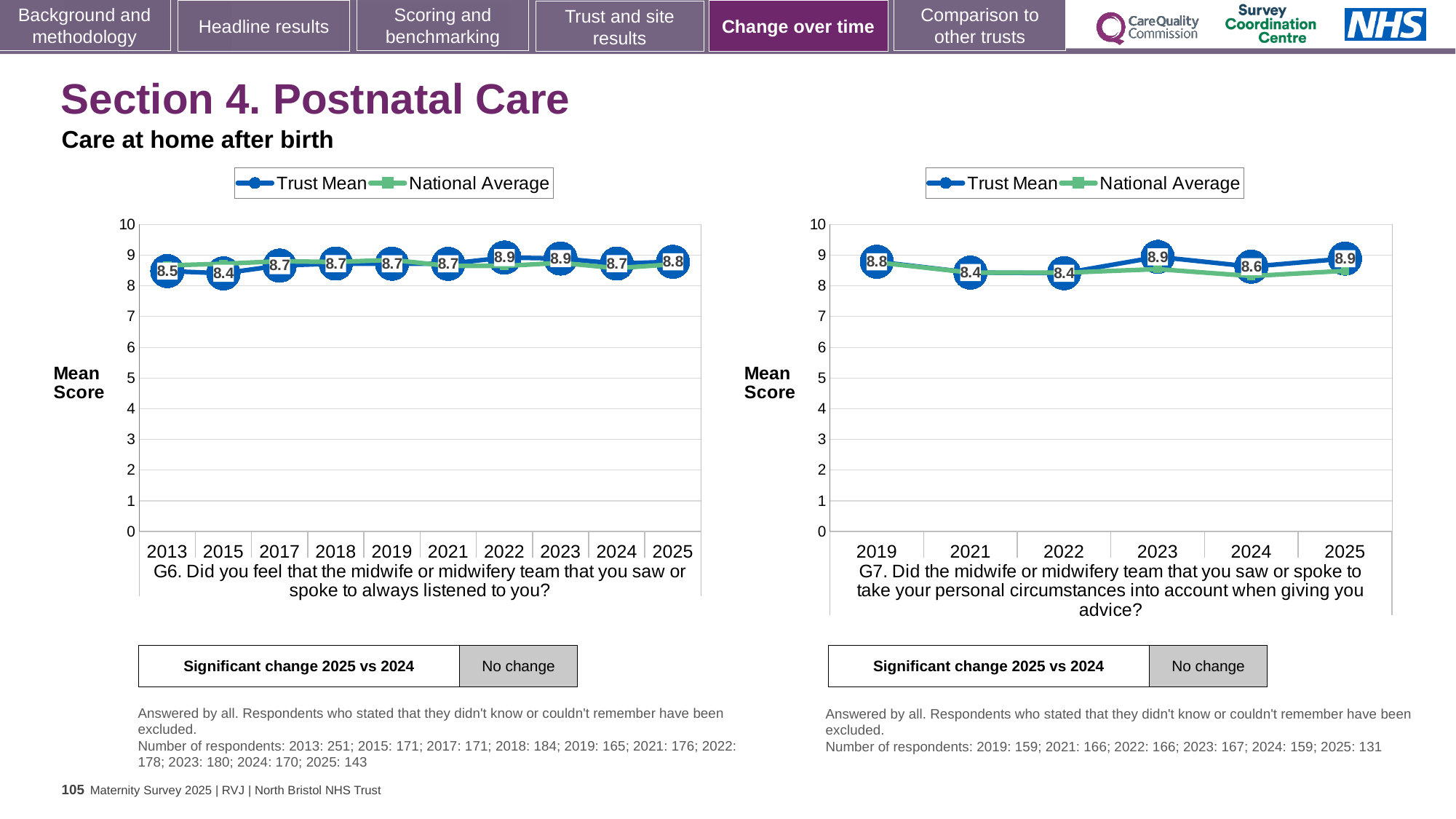
In the left chart (G6), which year has the lowest Trust Mean score? 2015 In the left chart (G6), how many years are plotted on the x axis? 10 In the left chart (G6), what is the difference between the Trust Mean scores for 2025 and 2013? 0.3 In the left chart (G6), is the Trust Mean score for 2022 larger or smaller than the score for 2015? larger In the left chart (G6), what is the Trust Mean score for 2025? 8.8 In the right chart (G7), what is the Trust Mean score for 2021? 8.4 How many series does the legend of the left chart (G6) list? 2 In the right chart (G7), is the National Average value for 2025 greater or less than 8? greater In the right chart (G7), what is the difference between the Trust Mean scores for 2023 and 2022? 0.5 In the right chart (G7), how many years are plotted on the x axis? 6 In the left chart (G6), what is the Trust Mean score for 2013? 8.5 In the right chart (G7), what is the Trust Mean score for 2024? 8.6